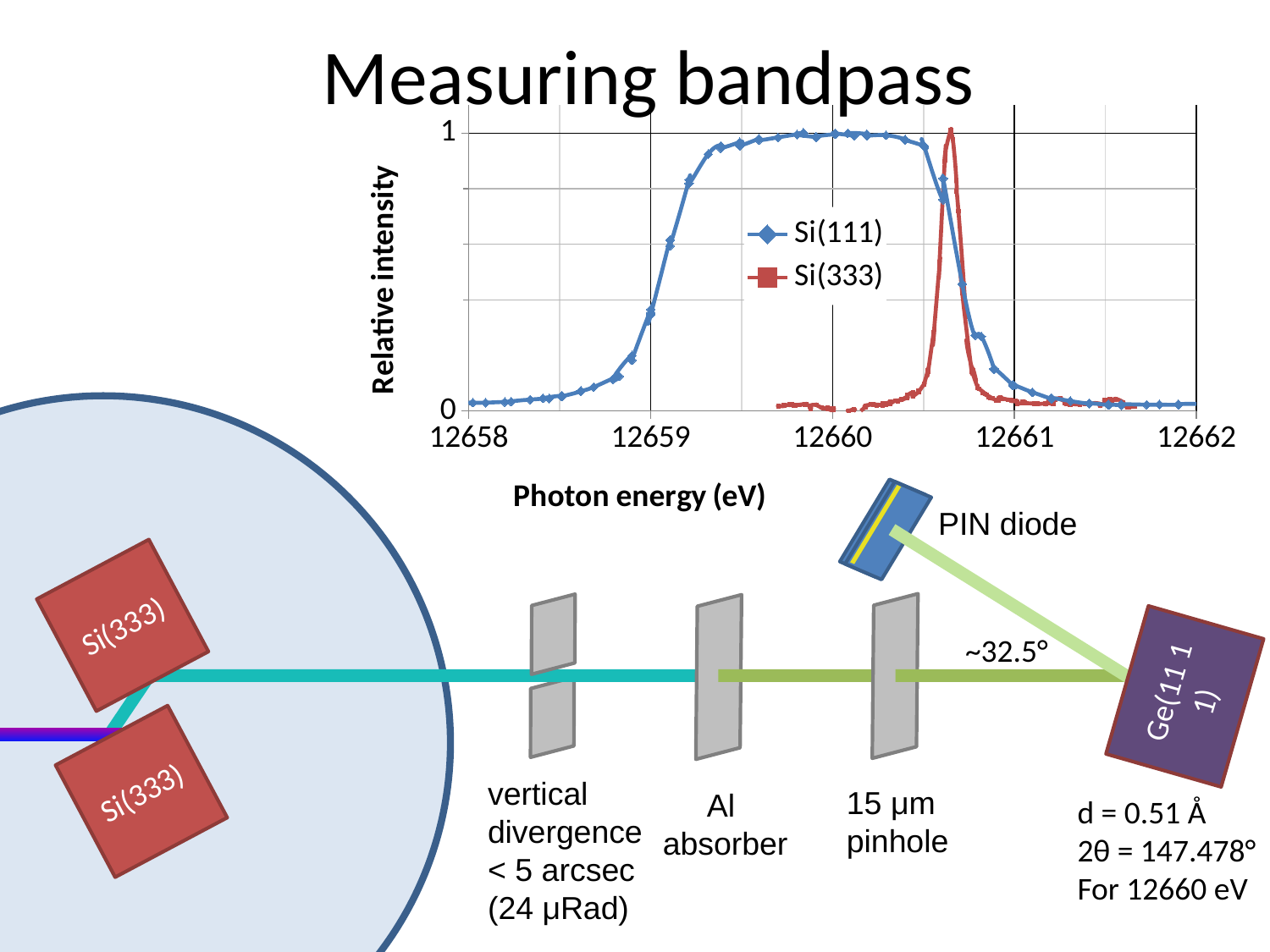
Is the relative intensity of Si(111) at 12660 eV greater or less than 0.5? greater Which series has the narrower peak, Si(111) or Si(333)? Si(333) Is the relative intensity of Si(111) at 12662 eV greater or less than 0.5? less Is the relative intensity of Si(111) at 12658 eV greater or less than 0.5? less At 12660 eV, which series has the higher relative intensity, Si(111) or Si(333)? Si(111) What kind of chart is shown on the slide? line chart What is the label of the x axis of the chart? Photon energy (eV) Does the Si(111) curve rise or fall between 12658 eV and 12660 eV? rise Does the Si(111) curve rise or fall between 12661 eV and 12662 eV? fall How many series does the chart legend list? 2 What are the two series named in the chart legend? Si(111) and Si(333)